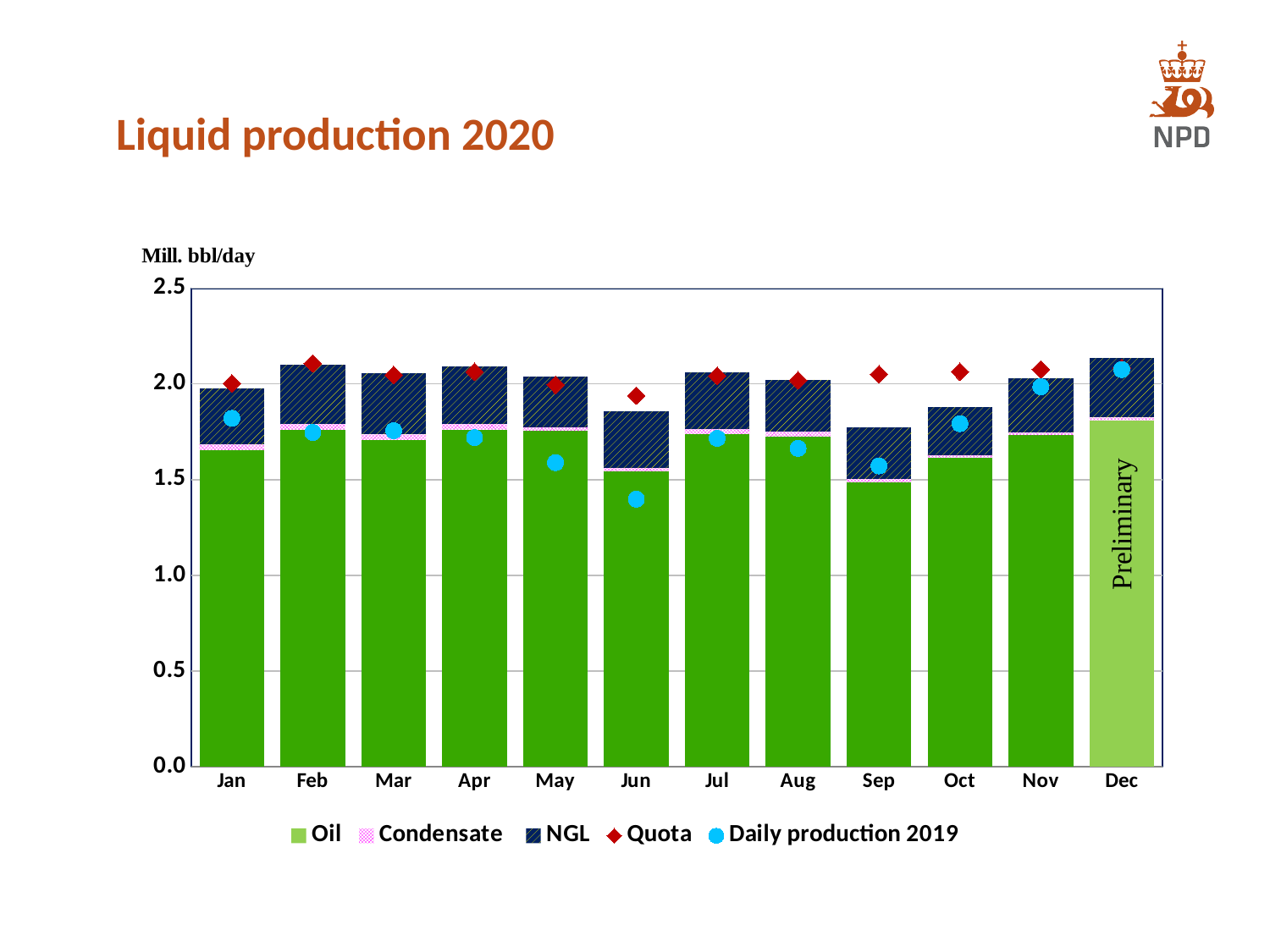
What is the title of the chart? Liquid production 2020 How many series does the legend list? 5 What kind of chart is shown on the slide? Stacked bar chart with line markers Which month has the lowest Daily production 2019 marker? Jun Is the total liquid production bar for Feb greater or less than 2.0? greater Which month has the highest Daily production 2019 marker? Dec Is the Oil segment for Jan greater or less than 1.5? greater Is the Daily production 2019 value for Jun greater or less than 1.5? less How many months (categories) are shown on the x axis? 12 What unit is shown on the y axis? Mill. bbl/day Which is larger, the total liquid production bar for Feb or for Jun? Feb